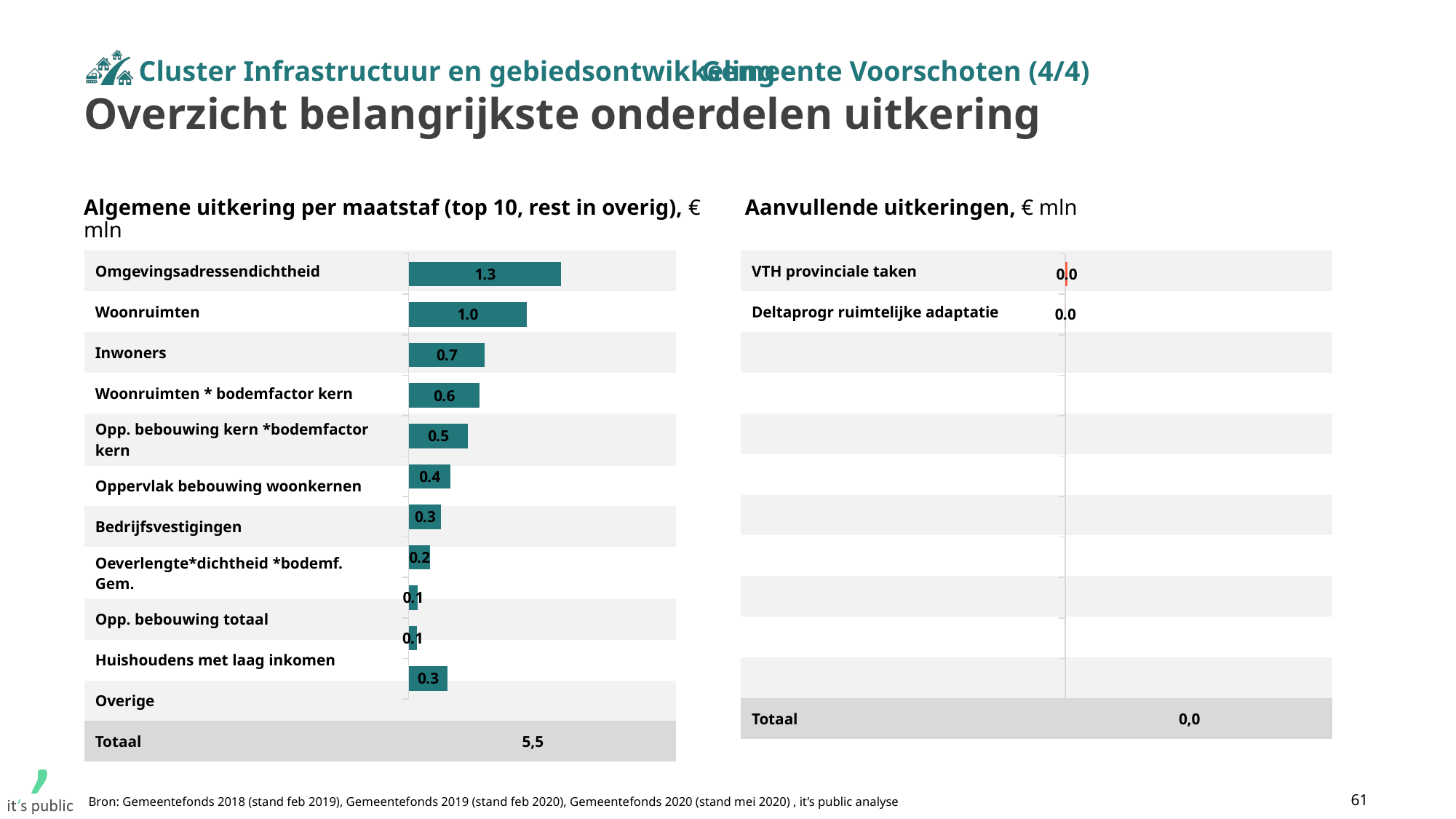
In the 'Algemene uitkering per maatstaf' chart, what is the value for Omgevingsadressendichtheid? 1.3 What type of chart is the 'Algemene uitkering per maatstaf' chart? Bar chart How many categories (including Overige) are plotted in the 'Algemene uitkering per maatstaf' chart? 11 In the 'Aanvullende uitkeringen' chart, what is the value for VTH provinciale taken? 0.0 In the 'Algemene uitkering per maatstaf' chart, which category has the highest value? Omgevingsadressendichtheid In the 'Algemene uitkering per maatstaf' chart, what is the value for Woonruimten? 1.0 In the 'Algemene uitkering per maatstaf' chart, what is the difference between Omgevingsadressendichtheid and Woonruimten? 0.3 In the 'Algemene uitkering per maatstaf' chart, what is the value for Bedrijfsvestigingen? 0.3 In the 'Algemene uitkering per maatstaf' chart, which is larger: Inwoners or Woonruimten * bodemfactor kern? Inwoners In the 'Aanvullende uitkeringen' chart, what is the Totaal shown at the bottom? 0,0 In the 'Algemene uitkering per maatstaf' chart, what is the Totaal shown at the bottom? 5,5 In the 'Algemene uitkering per maatstaf' chart, what is the value for Inwoners? 0.7